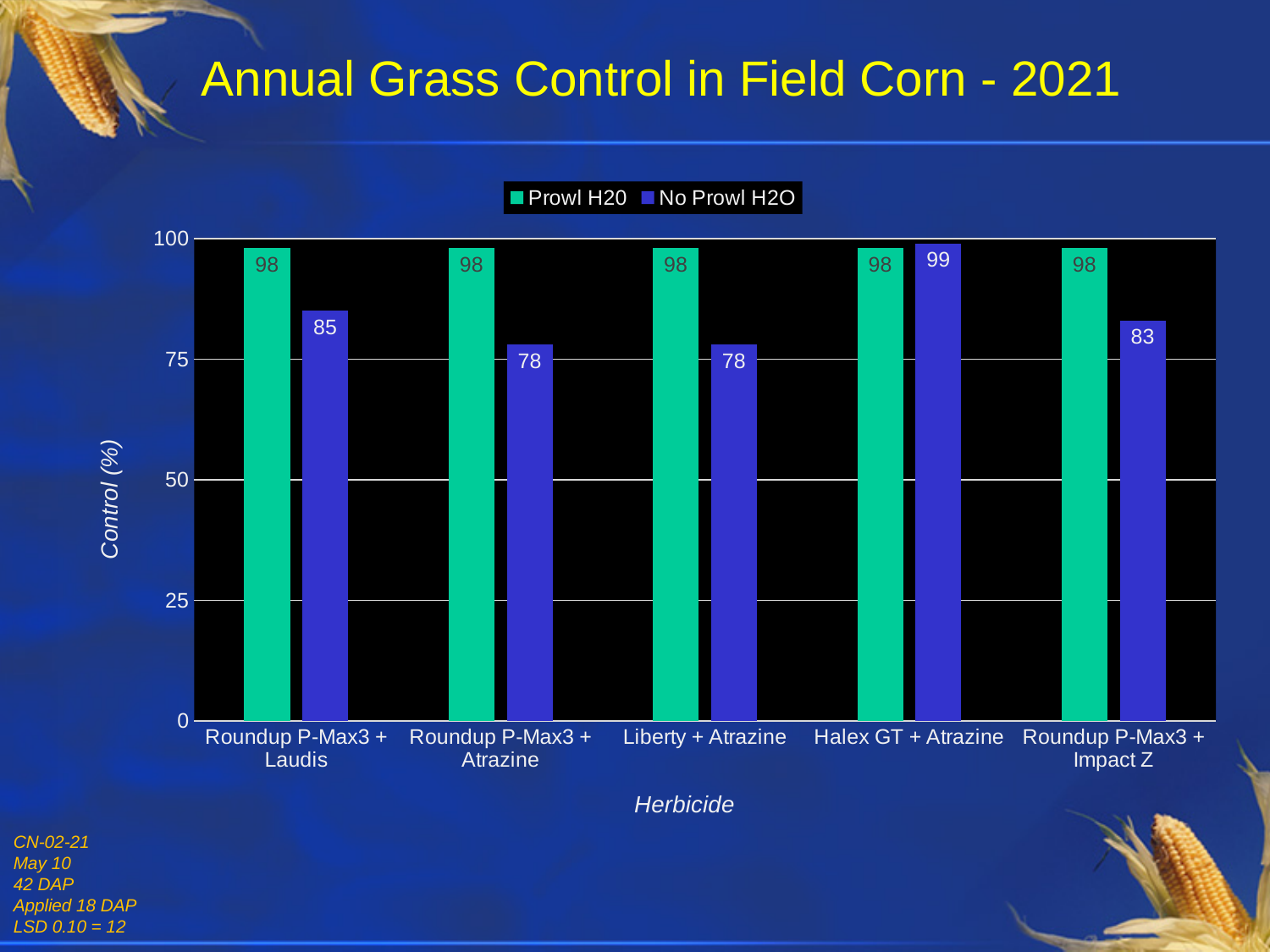
What is the No Prowl H2O value for Roundup P-Max3 + Atrazine? 78 What is the difference between the Prowl H20 and No Prowl H2O values for Roundup P-Max3 + Laudis? 13 Which is larger for Liberty + Atrazine, the Prowl H20 value or the No Prowl H2O value? Prowl H20 Which herbicide has the highest No Prowl H2O value? Halex GT + Atrazine What is the Prowl H20 value for Roundup P-Max3 + Laudis? 98 How many herbicides are shown on the x axis? 5 How many series does the legend list? 2 Which herbicide has the lowest No Prowl H2O value? Roundup P-Max3 + Atrazine and Liberty + Atrazine Is the No Prowl H2O value for Roundup P-Max3 + Impact Z greater or less than 75? greater What is the No Prowl H2O value for Roundup P-Max3 + Impact Z? 83 What is the No Prowl H2O value for Halex GT + Atrazine? 99 What kind of chart is shown on the slide? bar chart